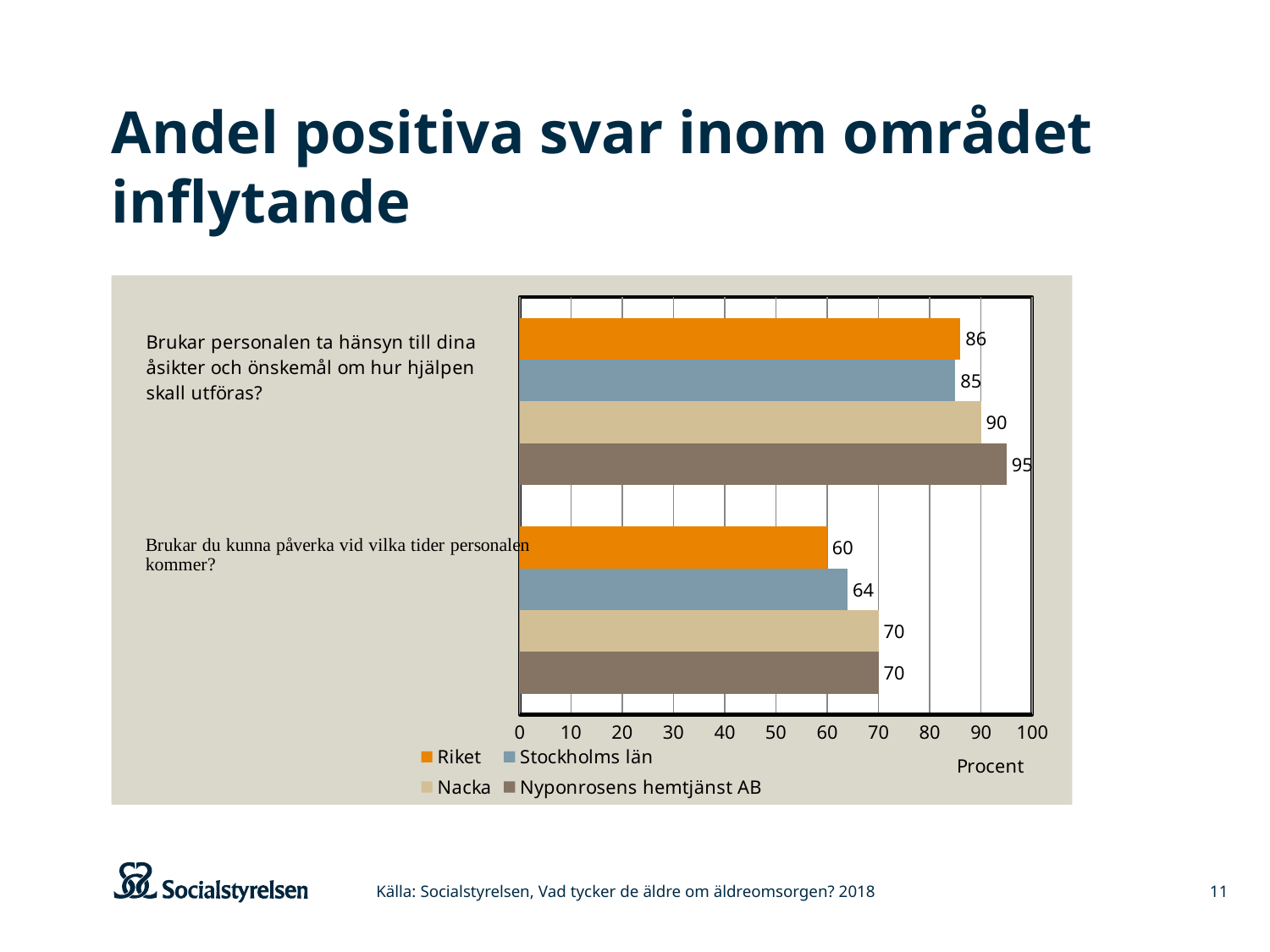
Which series has the highest value on the question "Brukar personalen ta hänsyn till dina åsikter och önskemål om hur hjälpen skall utföras?"? Nyponrosens hemtjänst AB Which is larger on the question "Brukar du kunna påverka vid vilka tider personalen kommer?": Riket or Stockholms län? Stockholms län Which series has the lowest value on the question "Brukar du kunna påverka vid vilka tider personalen kommer?"? Riket How many series does the legend list? 4 How many questions (categories) are shown on the chart? 2 What is the value for Nyponrosens hemtjänst AB on the question "Brukar personalen ta hänsyn till dina åsikter och önskemål om hur hjälpen skall utföras?"? 95 What is the label on the horizontal axis of the chart? Procent What is the value for Riket on the question "Brukar du kunna påverka vid vilka tider personalen kommer?"? 60 What is the value for Nacka on the question "Brukar du kunna påverka vid vilka tider personalen kommer?"? 70 What kind of chart is shown on the slide? Bar chart What is the difference between Nyponrosens hemtjänst AB and Riket on the question "Brukar personalen ta hänsyn till dina åsikter och önskemål om hur hjälpen skall utföras?"? 9 What is the value for Stockholms län on the question "Brukar personalen ta hänsyn till dina åsikter och önskemål om hur hjälpen skall utföras?"? 85